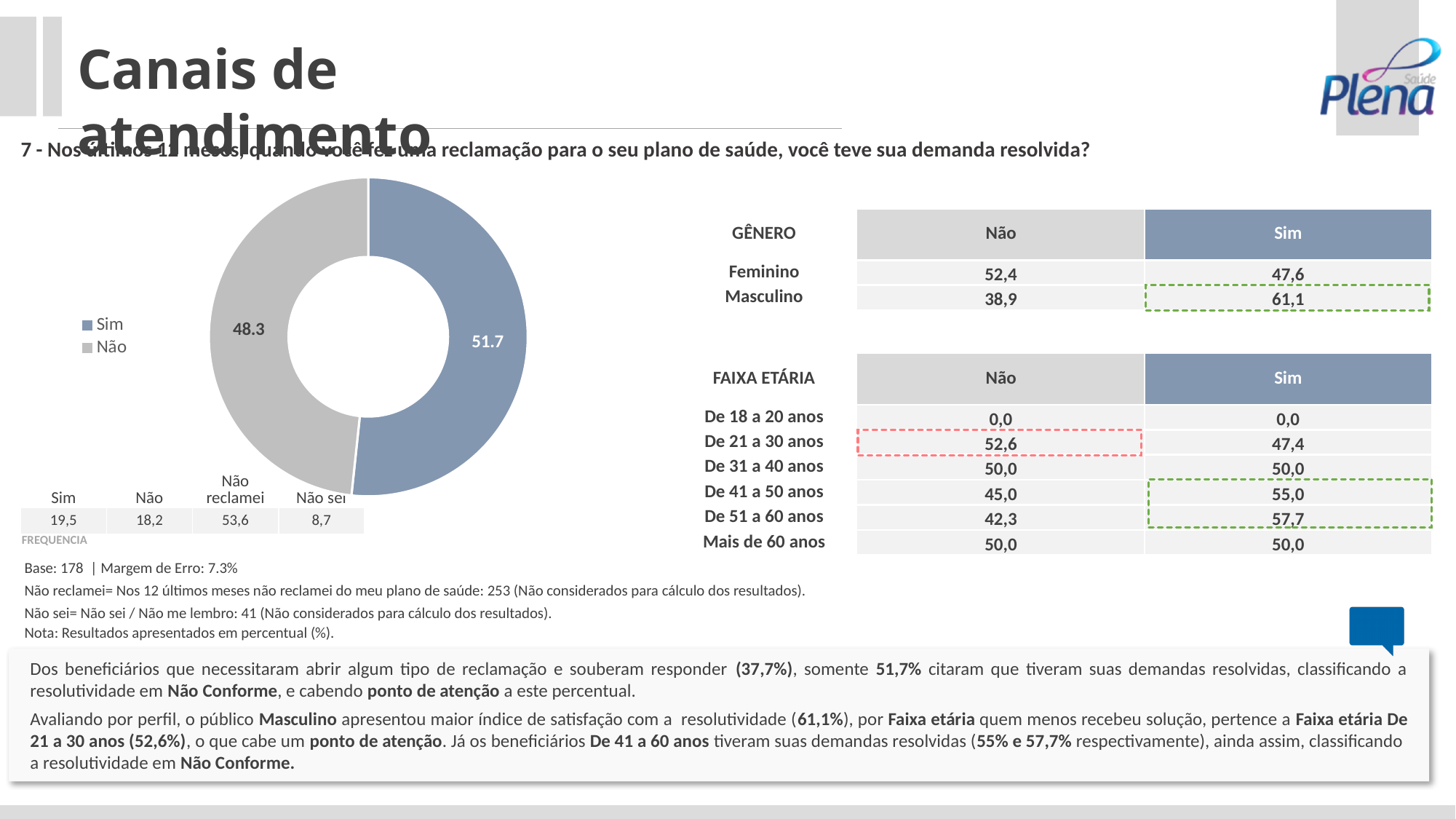
What type of chart is shown on the left of the slide? Donut (pie) chart What are the two legend entries of the donut chart? Sim and Não In the donut chart, which is larger: "Sim" or "Não"? Sim In the donut chart, what is the difference between the "Sim" value and the "Não" value? 3.4 Is the value for "Não" in the donut chart greater or less than 50? less Which slice of the donut chart is the largest? Sim In the donut chart, what is the value shown for the "Sim" slice? 51.7 How many slices does the donut chart have? 2 What share of the donut chart does the "Sim" slice represent? 51.7 What colour is the "Sim" slice in the donut chart? Blue In the donut chart, what is the value shown for the "Não" slice? 48.3 Which slice of the donut chart is the smallest? Não